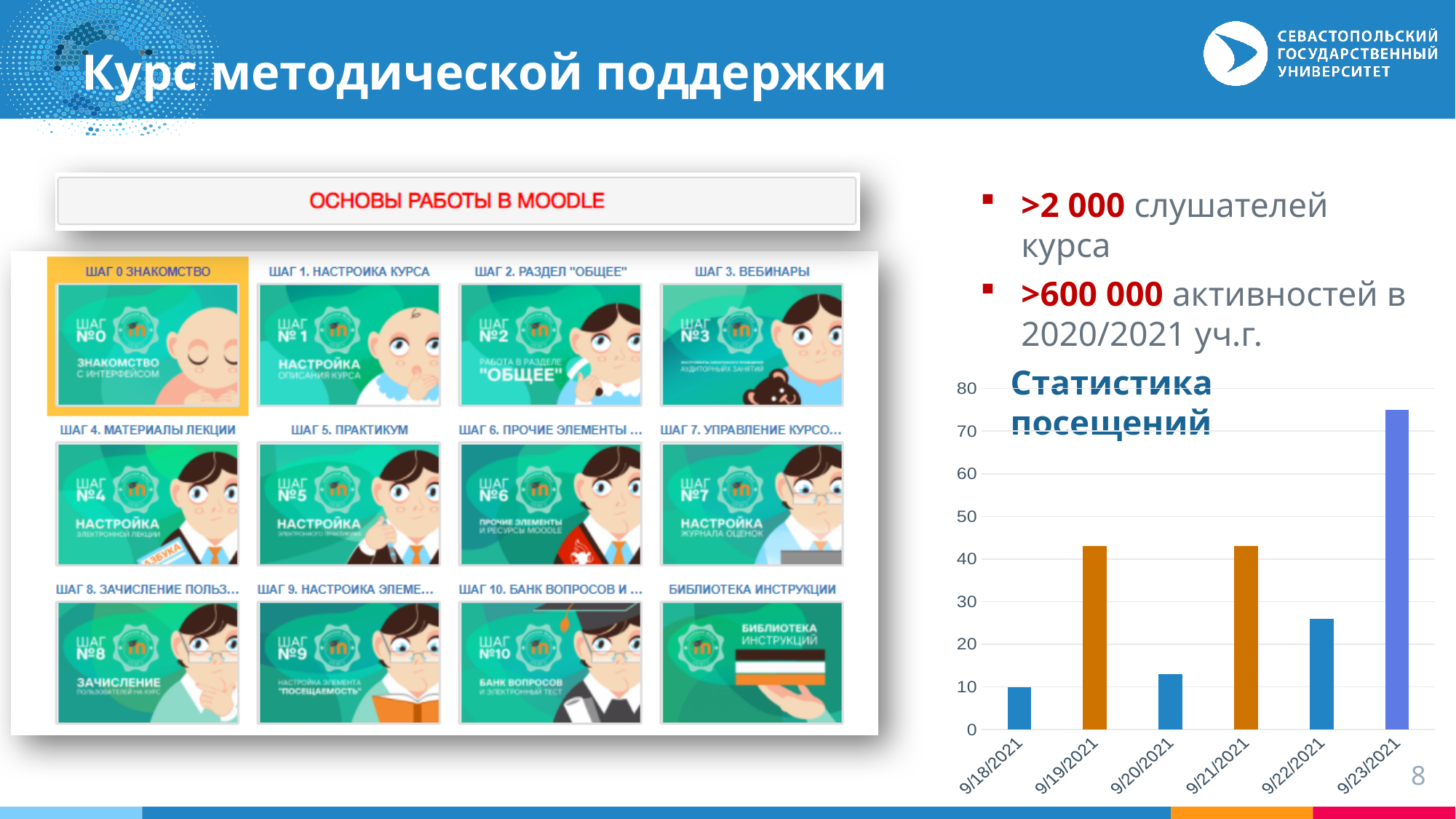
What is the highest value shown on the y axis of the "Статистика посещений" chart? 80 Is the value for 9/23/2021 greater or less than 70? greater Which is larger in the "Статистика посещений" chart, the value for 9/22/2021 or the value for 9/20/2021? 9/22/2021 How many dates are shown on the x axis of the "Статистика посещений" chart? 6 What kind of chart is shown under the title "Статистика посещений"? bar chart What is the title of the chart on the right side of the slide? Статистика посещений Is the value for 9/22/2021 greater or less than 30? less Is the value for 9/21/2021 greater or less than 40? greater Which date has the highest bar in the "Статистика посещений" chart? 9/23/2021